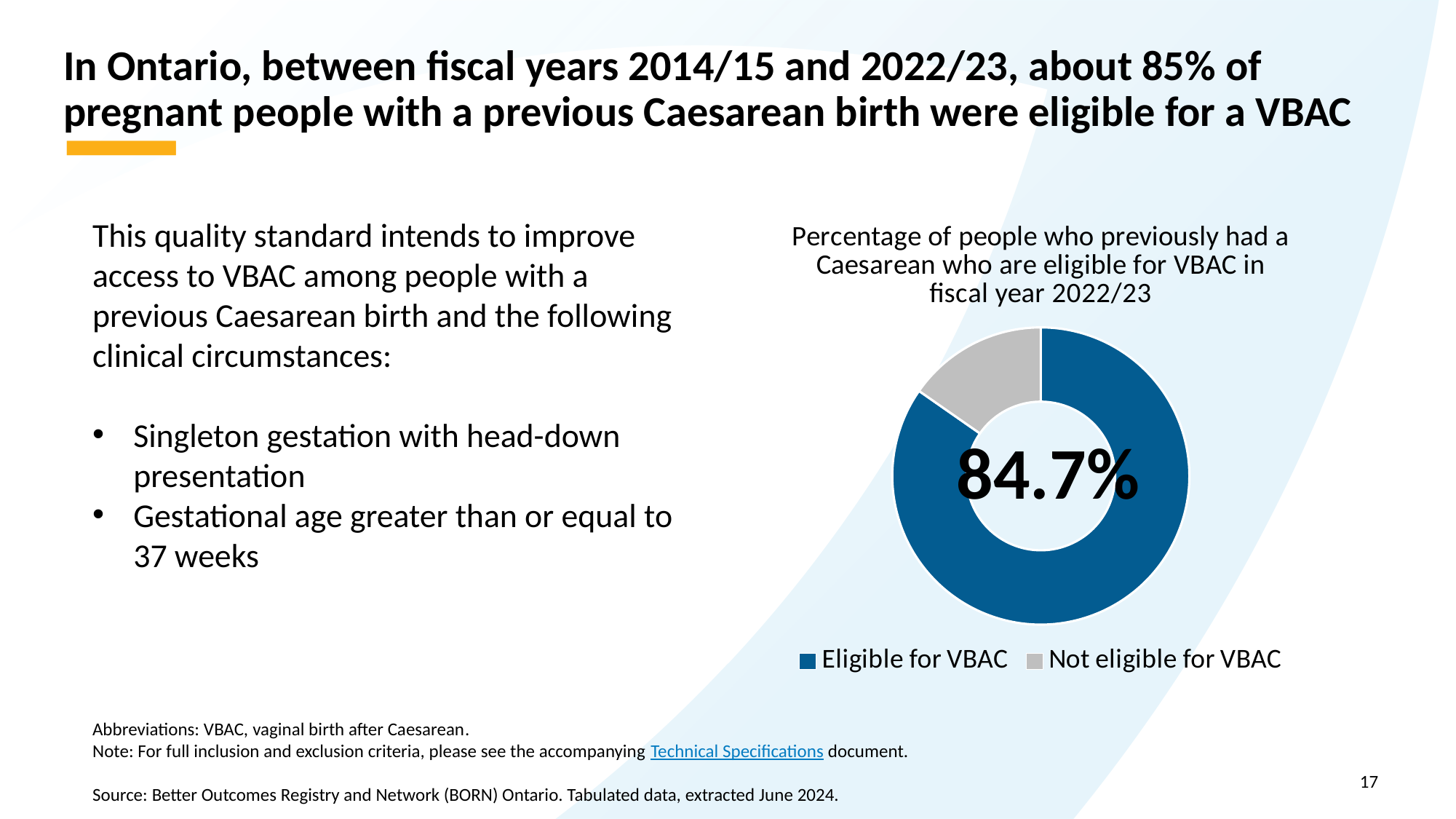
How many categories does the legend of the doughnut chart list? 2 Which category has the largest slice in the doughnut chart? Eligible for VBAC What kind of chart is shown on the slide? Doughnut (pie) chart Which slice of the doughnut chart is larger, 'Eligible for VBAC' or 'Not eligible for VBAC'? Eligible for VBAC Which category has the smallest slice in the doughnut chart? Not eligible for VBAC What percentage is printed in the centre of the doughnut chart? 84.7% Which fiscal year does the doughnut chart report on? 2022/23 What share of the doughnut chart does the 'Eligible for VBAC' slice represent? 84.7% What colour is the 'Not eligible for VBAC' slice in the doughnut chart? Grey What is the title of the doughnut chart? Percentage of people who previously had a Caesarean who are eligible for VBAC in fiscal year 2022/23